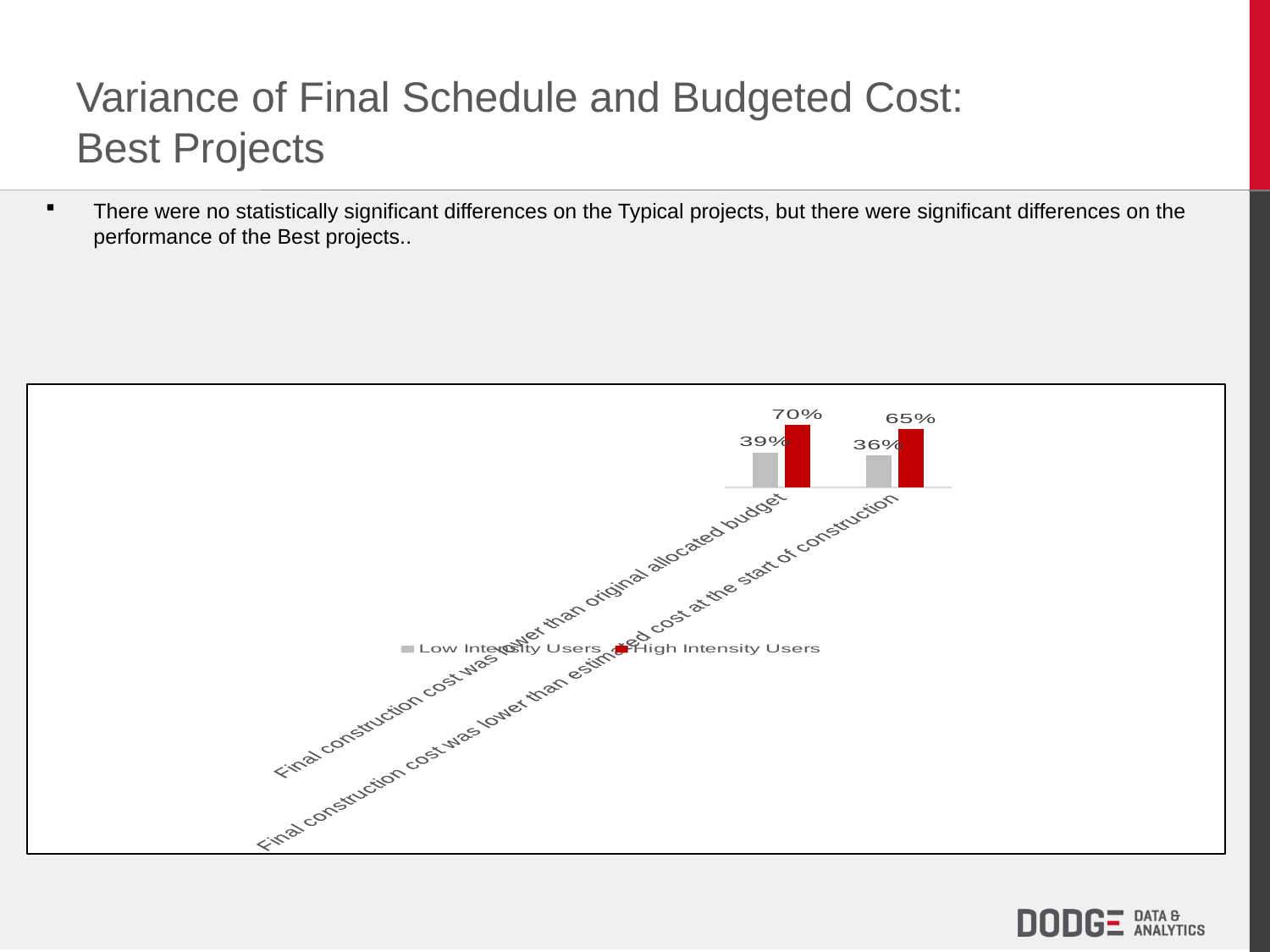
What is the difference between High Intensity Users and Low Intensity Users for 'Final construction cost was lower than estimated cost at the start of construction'? 29% Which series has the higher value for 'Final construction cost was lower than original allocated budget'? High Intensity Users What is the value for High Intensity Users for 'Final construction cost was lower than original allocated budget'? 70% Which bar on the chart has the lowest value? Low Intensity Users, Final construction cost was lower than estimated cost at the start of construction (36%) What kind of chart is shown on the slide? bar chart Which colour represents High Intensity Users in the legend? red What is the value for Low Intensity Users for 'Final construction cost was lower than estimated cost at the start of construction'? 36% What is the value for High Intensity Users for 'Final construction cost was lower than estimated cost at the start of construction'? 65% How many series does the legend list? 2 What is the value for Low Intensity Users for 'Final construction cost was lower than original allocated budget'? 39% What is the difference between High Intensity Users and Low Intensity Users for 'Final construction cost was lower than original allocated budget'? 31% How many categories are plotted on the chart? 2